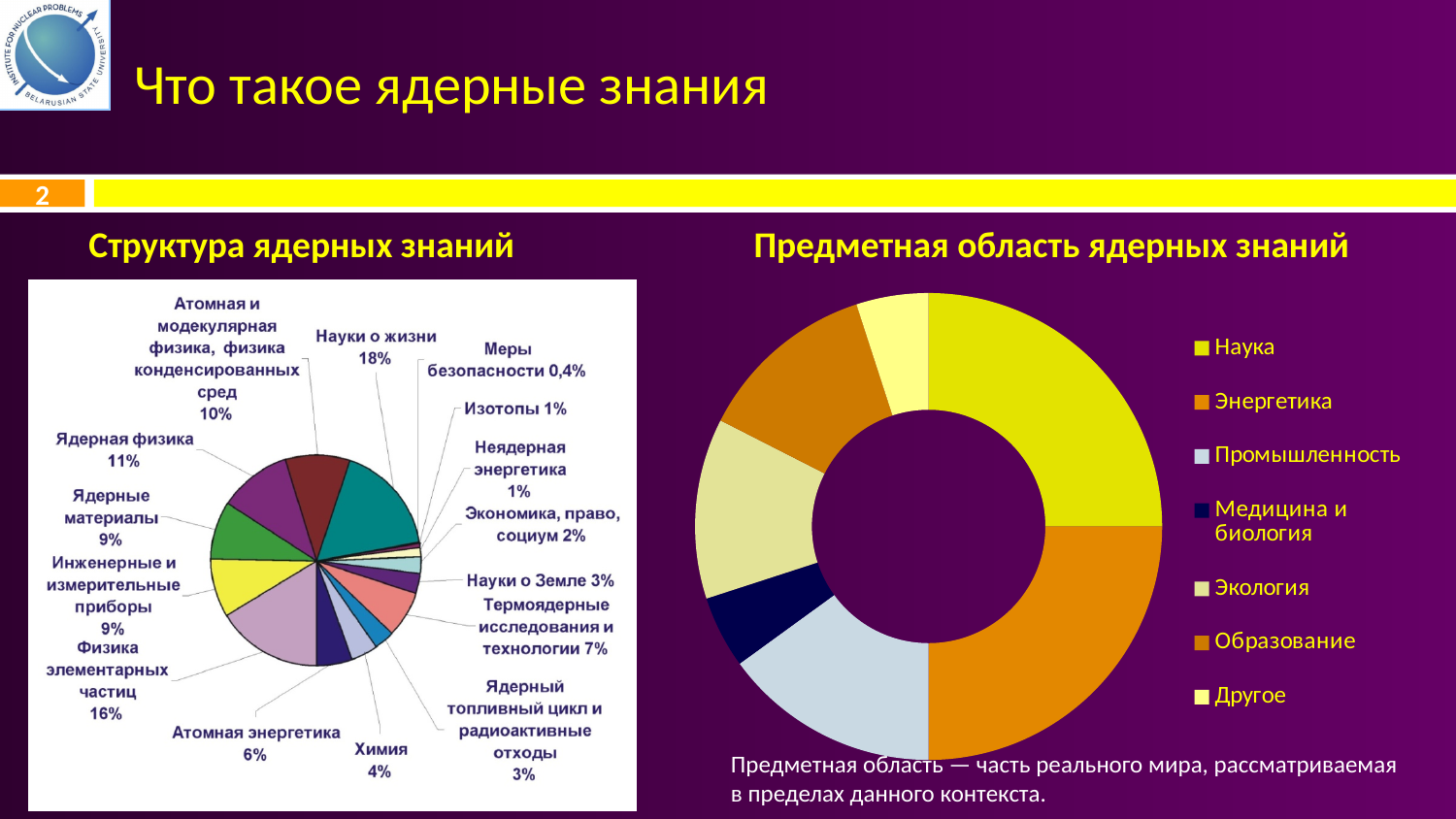
In the chart titled "Структура ядерных знаний", which category has the smallest share? Меры безопасности In the chart titled "Структура ядерных знаний", what is the value for Термоядерные исследования и технологии? 7% In the chart titled "Структура ядерных знаний", what is the difference between Ядерная физика and Атомная энергетика? 5% In the chart titled "Структура ядерных знаний", which is larger: Химия or Науки о Земле? Химия What kind of chart is the chart titled "Предметная область ядерных знаний"? Doughnut chart In the chart titled "Структура ядерных знаний", how many categories are shown? 15 In the chart titled "Структура ядерных знаний", which category has the largest share? Науки о жизни In the chart titled "Предметная область ядерных знаний", how many entries does the legend list? 7 In the chart titled "Структура ядерных знаний", what is the value for Физика элементарных частиц? 16% In the chart titled "Структура ядерных знаний", what is the value for Науки о жизни? 18% In the chart titled "Структура ядерных знаний", what is the value for Меры безопасности? 0,4%